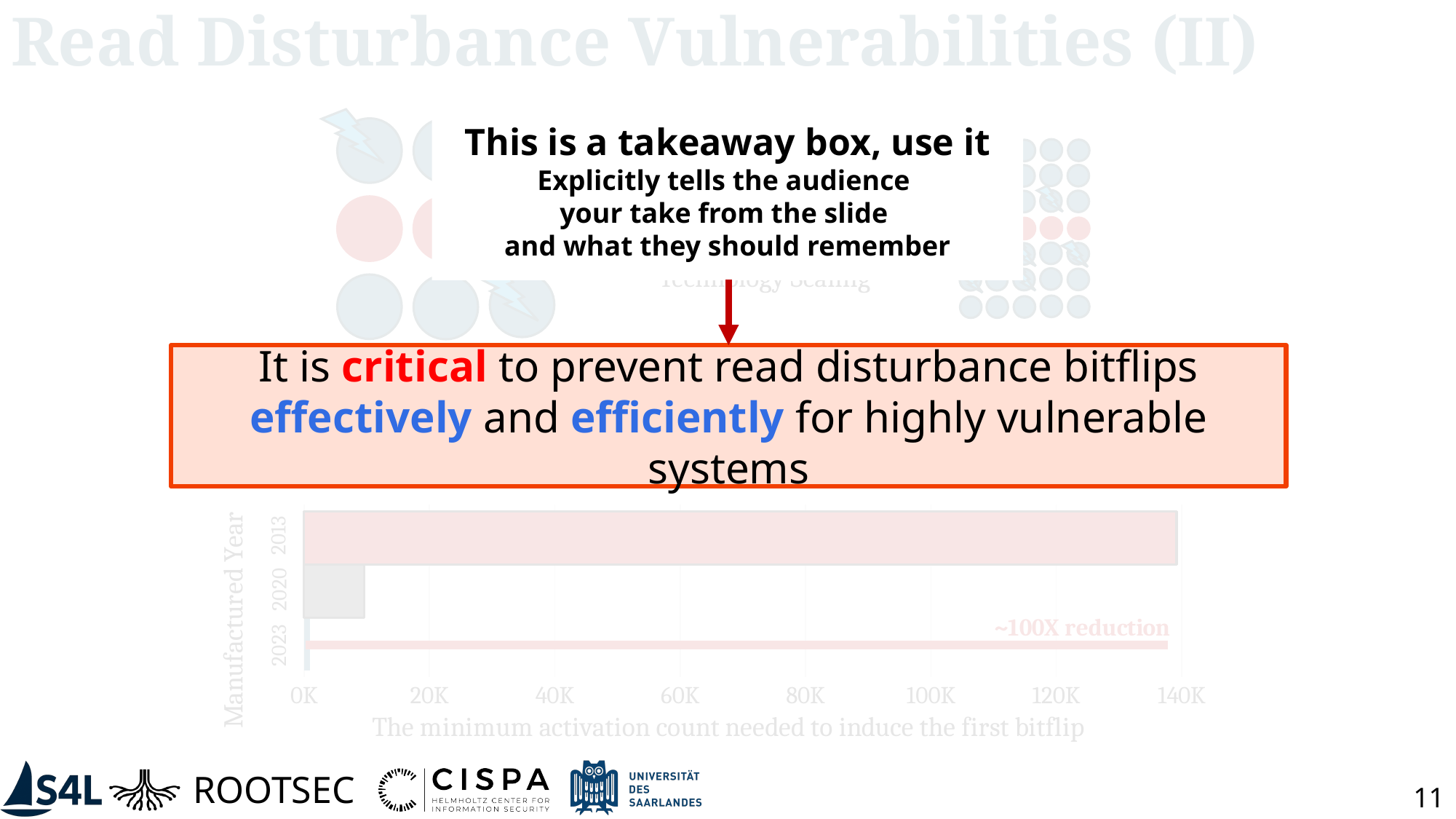
Which has the larger minimum activation count, 2020 or 2023? 2020 How many manufactured years are plotted on the y axis of the chart? 3 What reduction is annotated on the chart? ~100X reduction What is the title of the x axis of the chart? The minimum activation count needed to induce the first bitflip Is the bar for 2023 greater or less than 20K? less Which manufactured year has the lowest minimum activation count in the chart? 2023 Is the bar for 2020 greater or less than 20K? less Which has the larger minimum activation count, 2013 or 2020? 2013 Does the minimum activation count rise or fall as the manufactured year goes from 2013 to 2023? fall Which manufactured year has the highest minimum activation count in the chart? 2013 What kind of chart is shown at the bottom of the slide? bar chart Is the bar for 2013 greater or less than 120K? greater